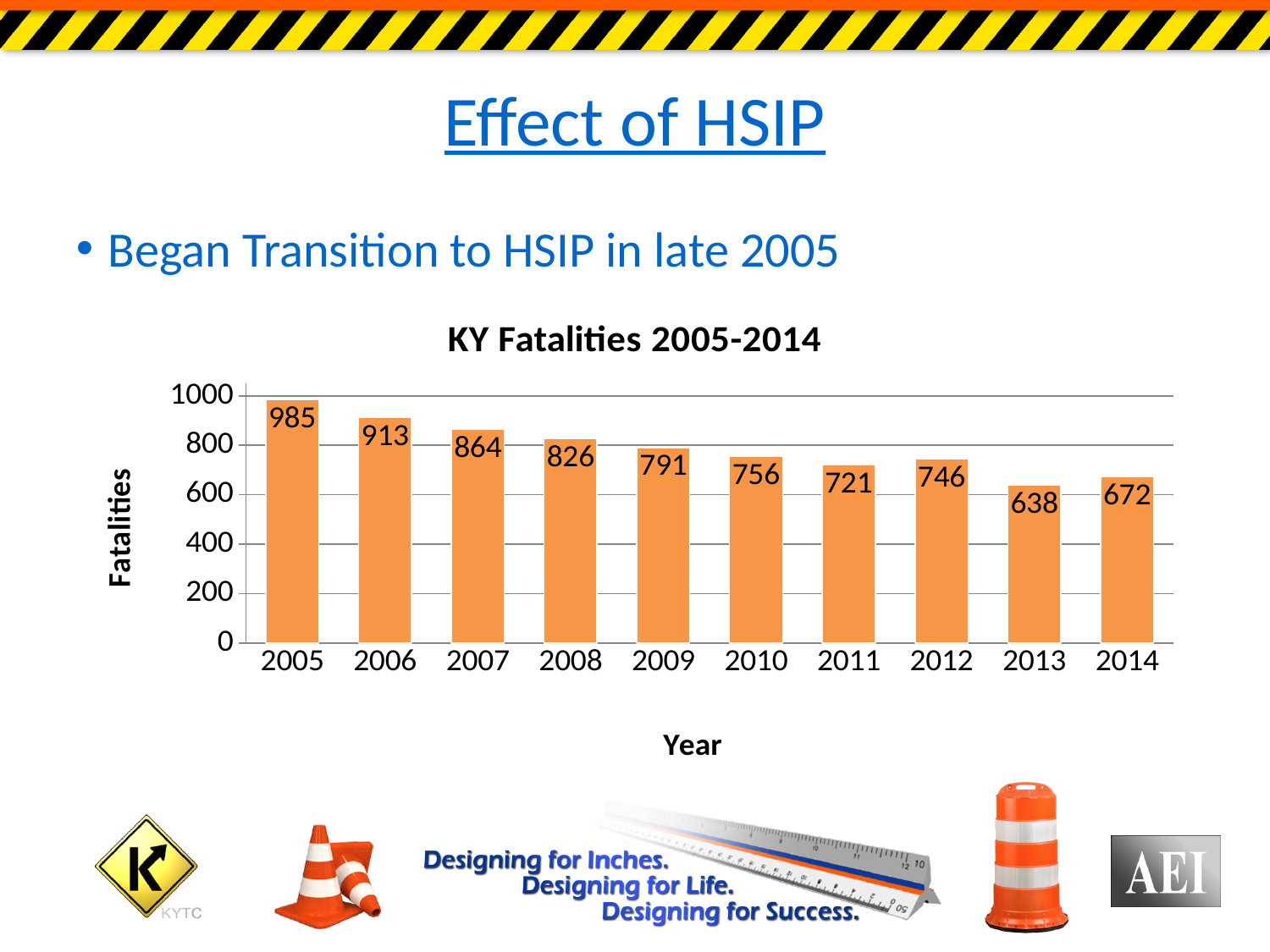
What is the difference in fatalities between 2005 and 2014? 313 What kind of chart is shown on the slide? bar chart What is the number of KY fatalities in 2005? 985 What is the difference in fatalities between 2012 and 2013? 108 Which year has the highest number of fatalities? 2005 What is the number of KY fatalities in 2010? 756 Is the value for 2009 greater or less than 800? less What is the number of KY fatalities in 2013? 638 How many years are shown on the x axis of the chart? 10 Which year has the lowest number of fatalities? 2013 What is the title of the chart? KY Fatalities 2005-2014 Which year had more fatalities, 2011 or 2012? 2012